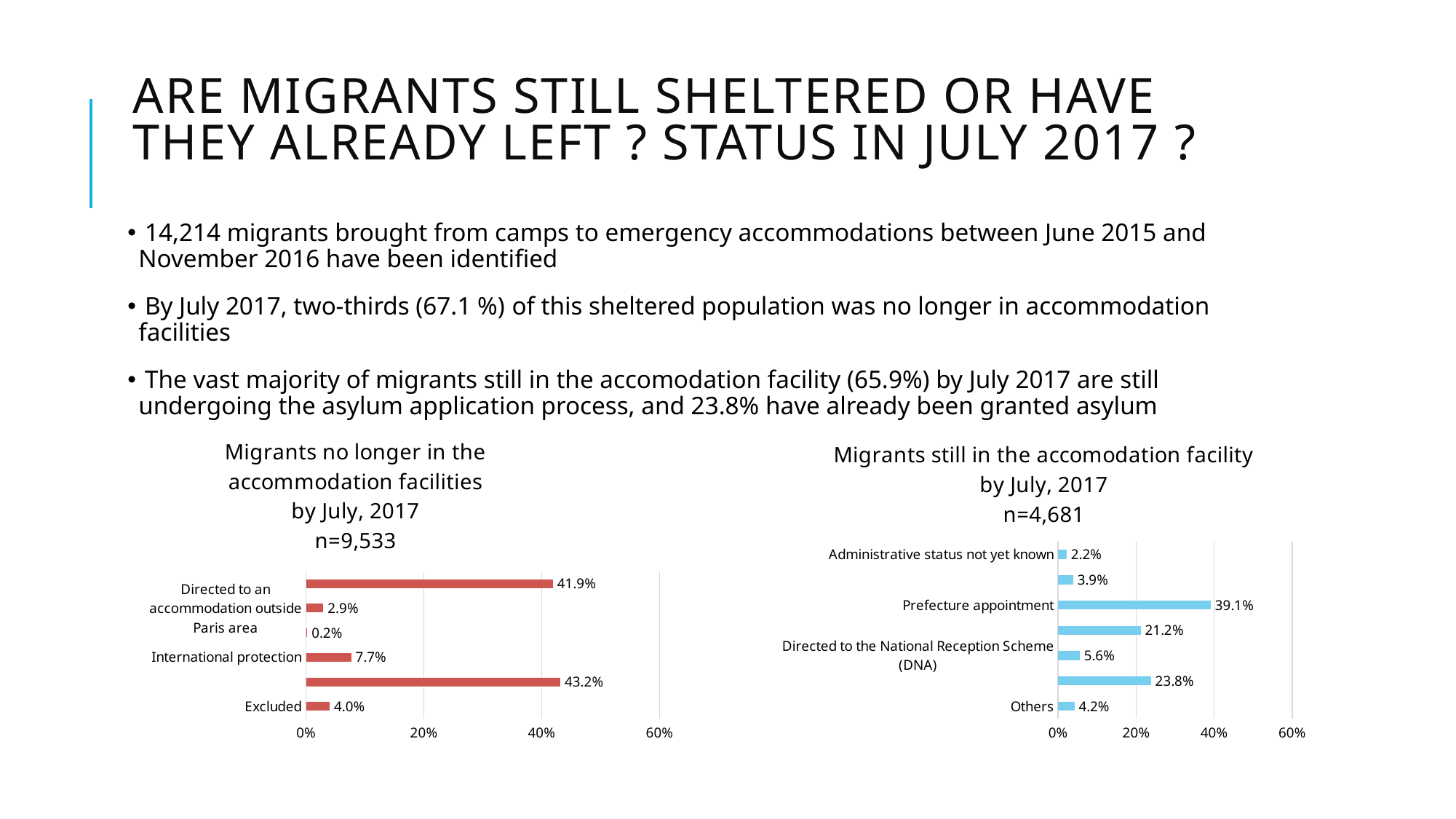
What type of chart is the 'Migrants no longer in the accommodation facilities by July, 2017' chart? Bar chart In the 'Migrants no longer in the accommodation facilities by July, 2017' chart, what is the value for Excluded? 4.0% In the 'Migrants still in the accomodation facility by July, 2017' chart, what is the value for Directed to the National Reception Scheme (DNA)? 5.6% How many bars are plotted in the 'Migrants still in the accomodation facility by July, 2017' chart? 7 How many bars are plotted in the 'Migrants no longer in the accommodation facilities by July, 2017' chart? 6 In the 'Migrants no longer in the accommodation facilities by July, 2017' chart, what is the value for International protection? 7.7% In the 'Migrants still in the accomodation facility by July, 2017' chart, what is the difference between the values for Prefecture appointment and Others? 34.9% In the 'Migrants still in the accomodation facility by July, 2017' chart, what is the value for Prefecture appointment? 39.1% In the 'Migrants still in the accomodation facility by July, 2017' chart, what is the value for Others? 4.2% In the 'Migrants no longer in the accommodation facilities by July, 2017' chart, what is the difference between the values for International protection and Excluded? 3.7% In the 'Migrants still in the accomodation facility by July, 2017' chart, which category has the lowest value? Administrative status not yet known In the 'Migrants still in the accomodation facility by July, 2017' chart, which category has the highest value? Prefecture appointment